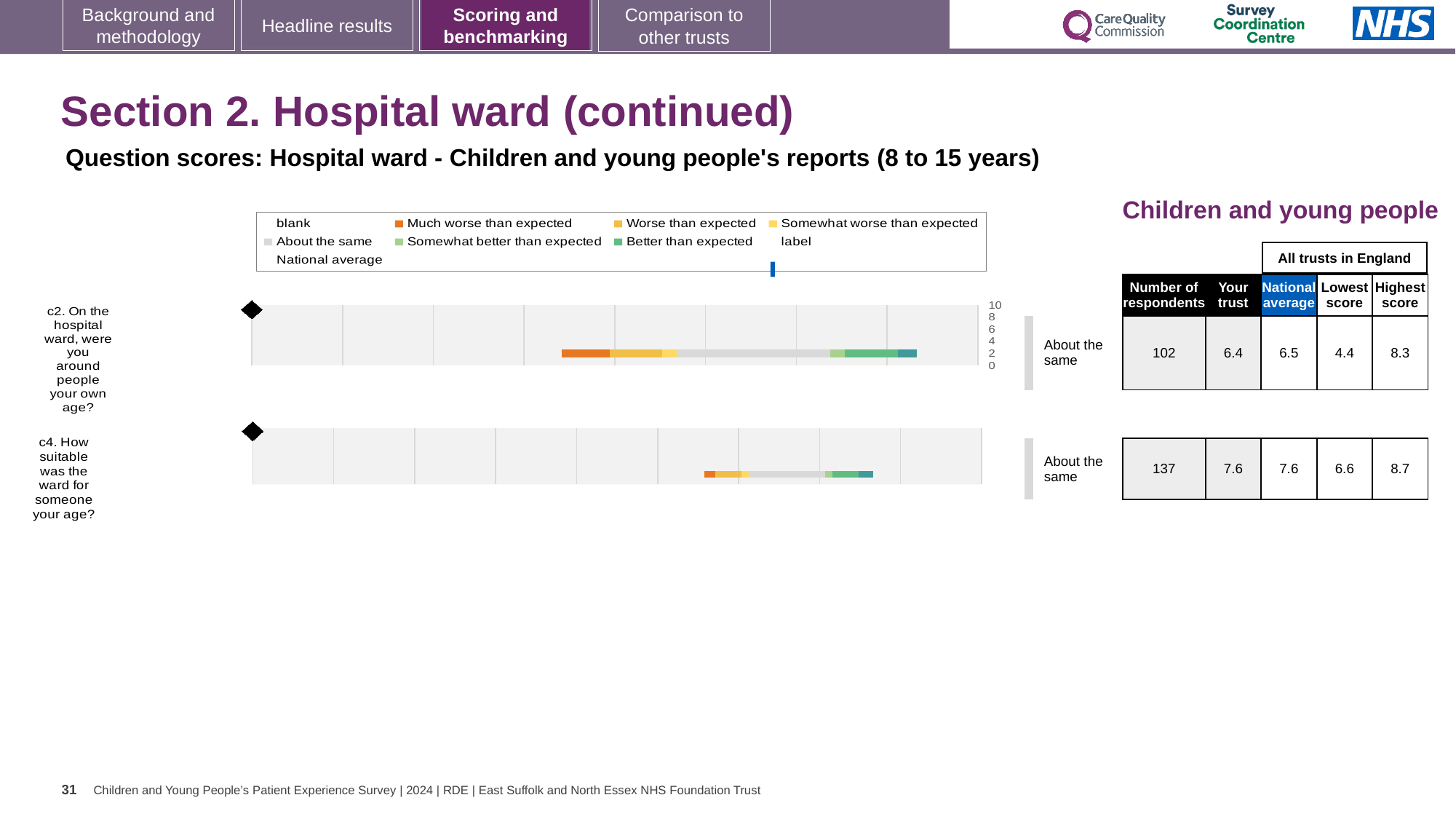
What is the maximum value shown on the score axis of the charts? 10 For question c2, what is the National average score? 6.5 For question c2 (On the hospital ward, were you around people your own age?), what is the score for Your trust? 6.4 For question c4, what is the Highest score among all trusts in England? 8.7 How many respondents answered question c4? 137 For question c4 (How suitable was the ward for someone your age?), what is the score for Your trust? 7.6 What is the difference between the Highest score and the Lowest score for question c2? 3.9 How many questions (c2 and c4) are plotted on the slide? 2 What kind of chart is used to show the question scores for c2 and c4? bar chart What is the benchmark category shown for question c2? About the same For question c2, what is the Lowest score among all trusts in England? 4.4 Which question has the higher Your trust score, c2 or c4? c4